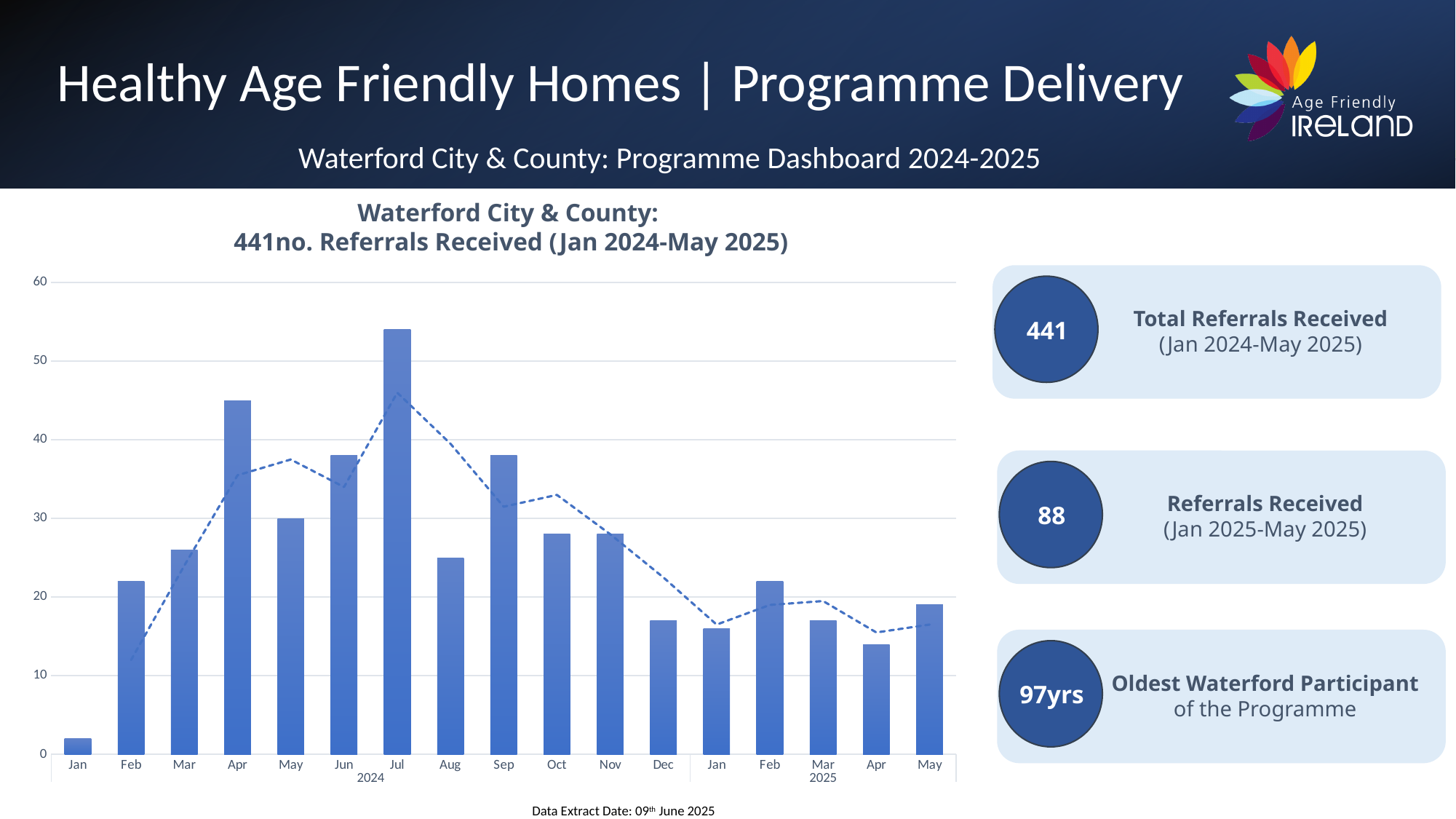
Do the referral values rise or fall from Jul 2024 to Dec 2024? fall How many months are shown on the x axis of the chart? 17 What is the title of the chart? Waterford City & County: 441no. Referrals Received (Jan 2024-May 2025) Which month has more referrals received, Feb 2024 or Mar 2024? Mar 2024 Which month has more referrals received, Apr 2024 or Sep 2024? Apr 2024 Which month has the highest number of referrals received? Jul 2024 Is the value for Dec 2024 greater or less than 20? less What kind of chart is used to show the monthly referrals received? bar chart Which month has the lowest number of referrals received? Jan 2024 Is the value for Jul 2024 greater or less than 50? greater Is the value for Apr 2024 greater or less than 40? greater